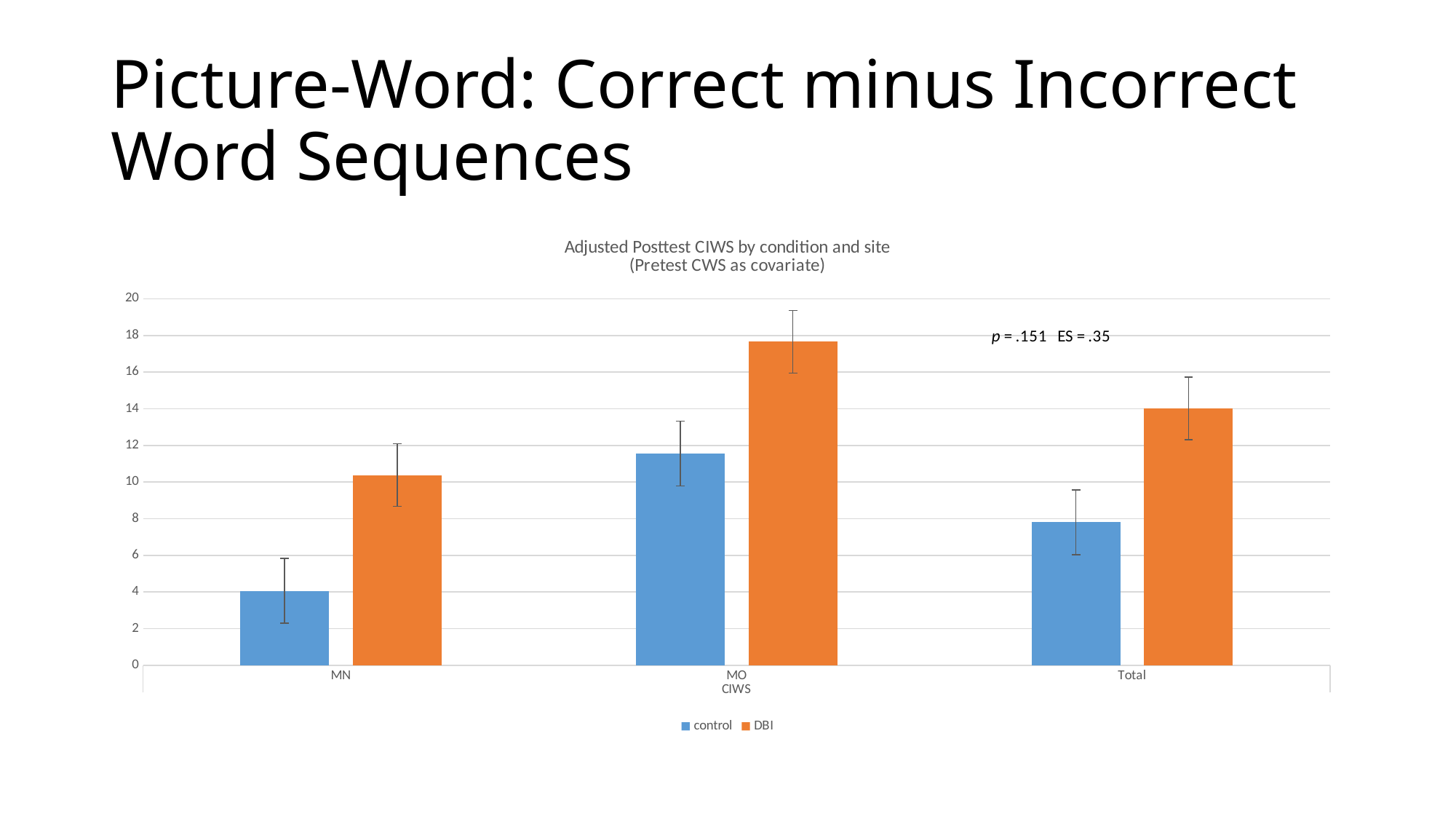
Is the DBI value for MN greater or less than 8? greater For the Total category, which is larger, the control bar or the DBI bar? DBI Which category has the highest DBI bar? MO Which is larger, the control value for MO or the control value for MN? MO Is the DBI value for MO greater or less than 16? greater What kind of chart is shown on the slide? bar chart How many series does the legend list? 2 What are the two series named in the legend? control and DBI Is the control value for Total greater or less than 10? less How many categories are shown on the x axis? 3 Which category has the lowest control bar? MN